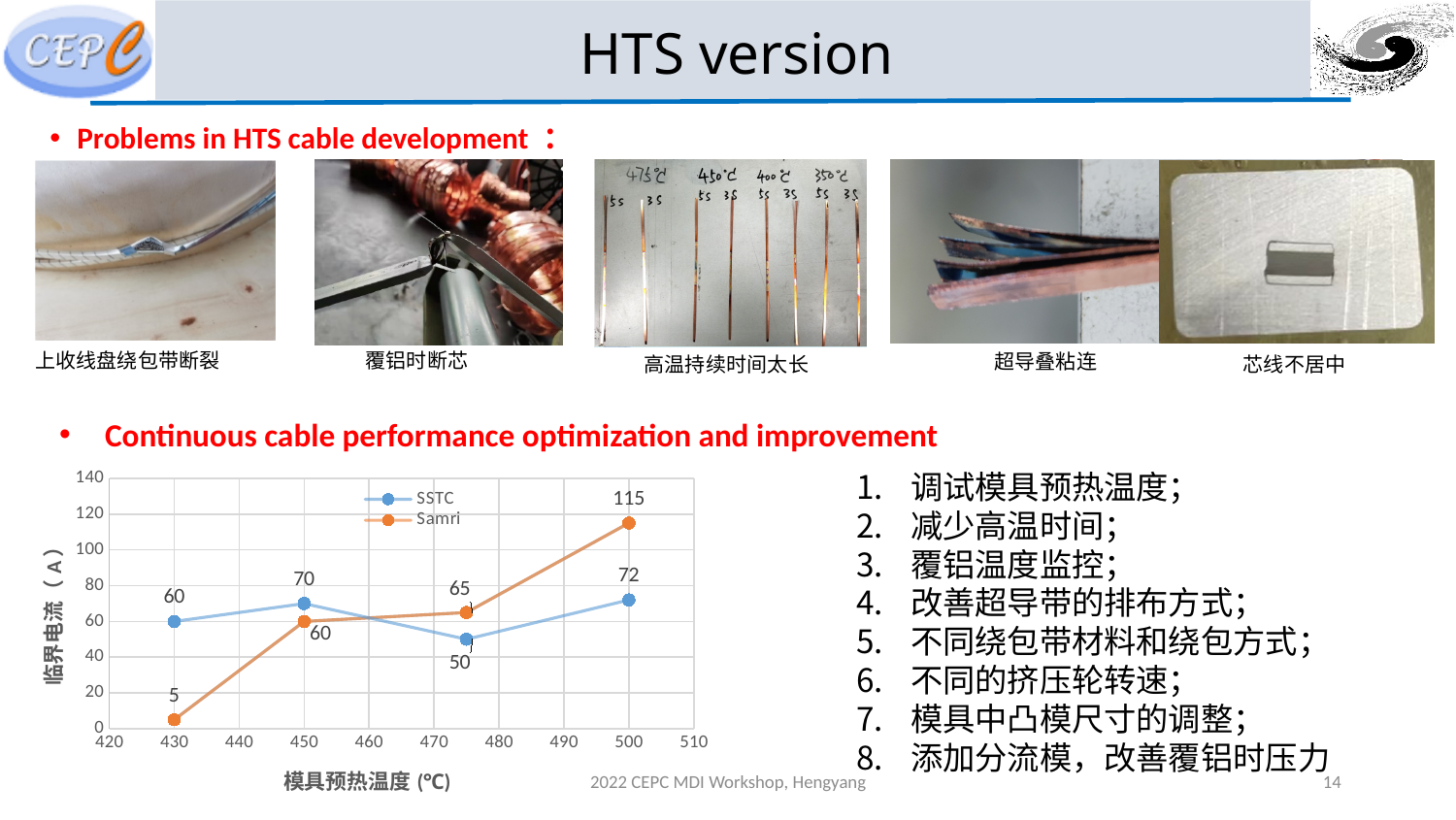
What is the critical current value for Samri at 430 °C? 5 What is the critical current value for SSTC at a mold preheat temperature of 500 °C? 72 What is the critical current value for SSTC at 475 °C? 50 At which mold preheat temperature does the Samri series reach its highest value? 500 What is the difference between the Samri and SSTC values at 500 °C? 43 What are the two series named in the chart legend? SSTC and Samri How many series does the chart legend list? 2 At 450 °C, which series has the larger critical current, SSTC or Samri? SSTC What type of chart is shown on the slide? line chart At which mold preheat temperature does the SSTC series have its lowest value? 475 What is the critical current value for Samri at a mold preheat temperature of 500 °C? 115 How many data points are plotted for the Samri series? 4